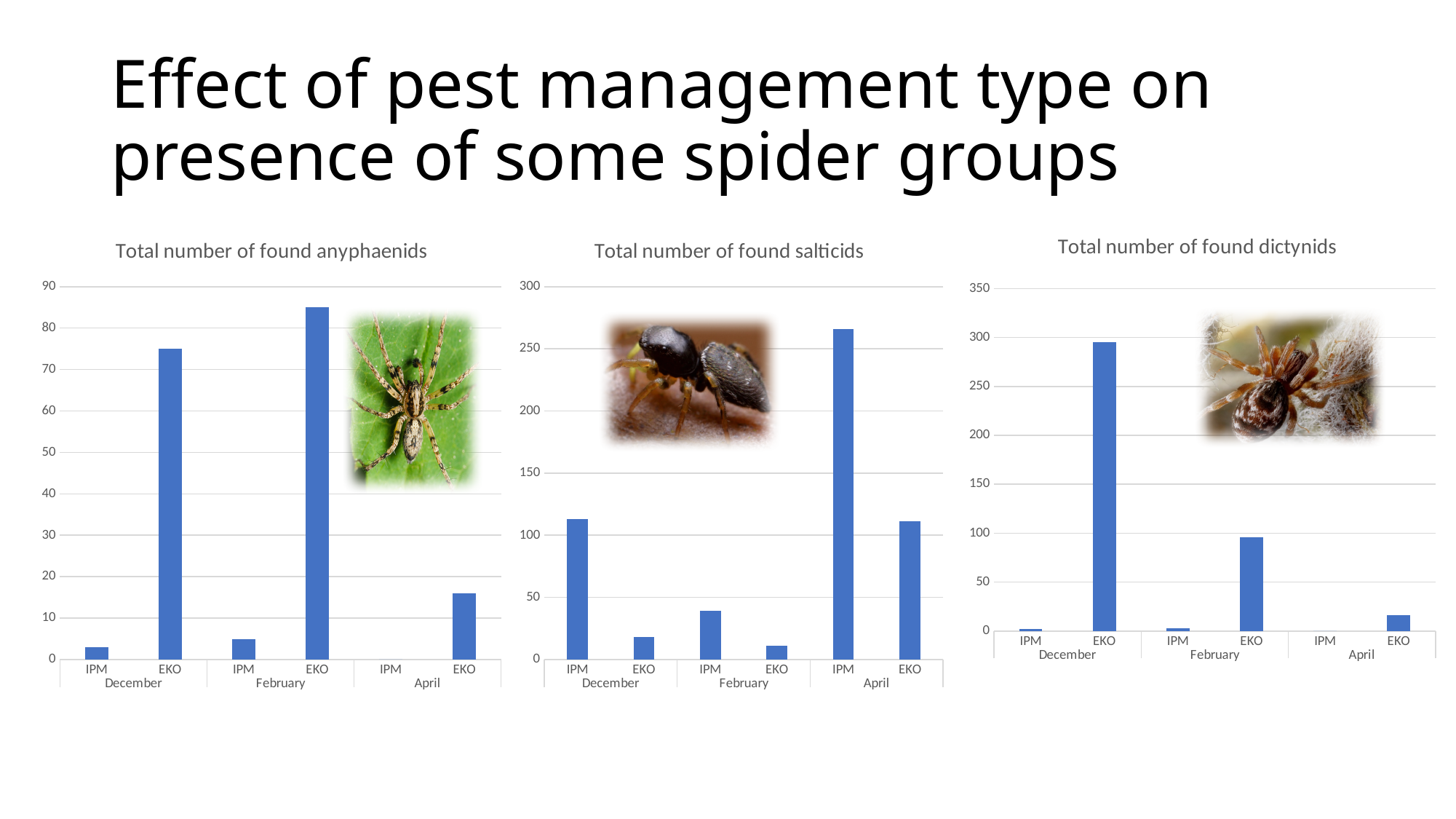
In the 'Total number of found salticids' chart, which bar is the highest? IPM in April In the 'Total number of found salticids' chart, which is larger, IPM in February or EKO in February? IPM in February How many bars are plotted in the 'Total number of found salticids' chart? 6 In the 'Total number of found salticids' chart, which bar is the lowest? EKO in February In the 'Total number of found dictynids' chart, which is larger, EKO in December or EKO in April? EKO in December What type of chart is the 'Total number of found dictynids' chart? Bar chart In the 'Total number of found dictynids' chart, which bar is the highest? EKO in December In the 'Total number of found salticids' chart, is the value for IPM in December greater or less than 100? greater In the 'Total number of found anyphaenids' chart, is the value for EKO in April greater or less than 20? less In the 'Total number of found anyphaenids' chart, is the value for EKO in December greater or less than 70? greater In the 'Total number of found anyphaenids' chart, which bar is the highest? EKO in February